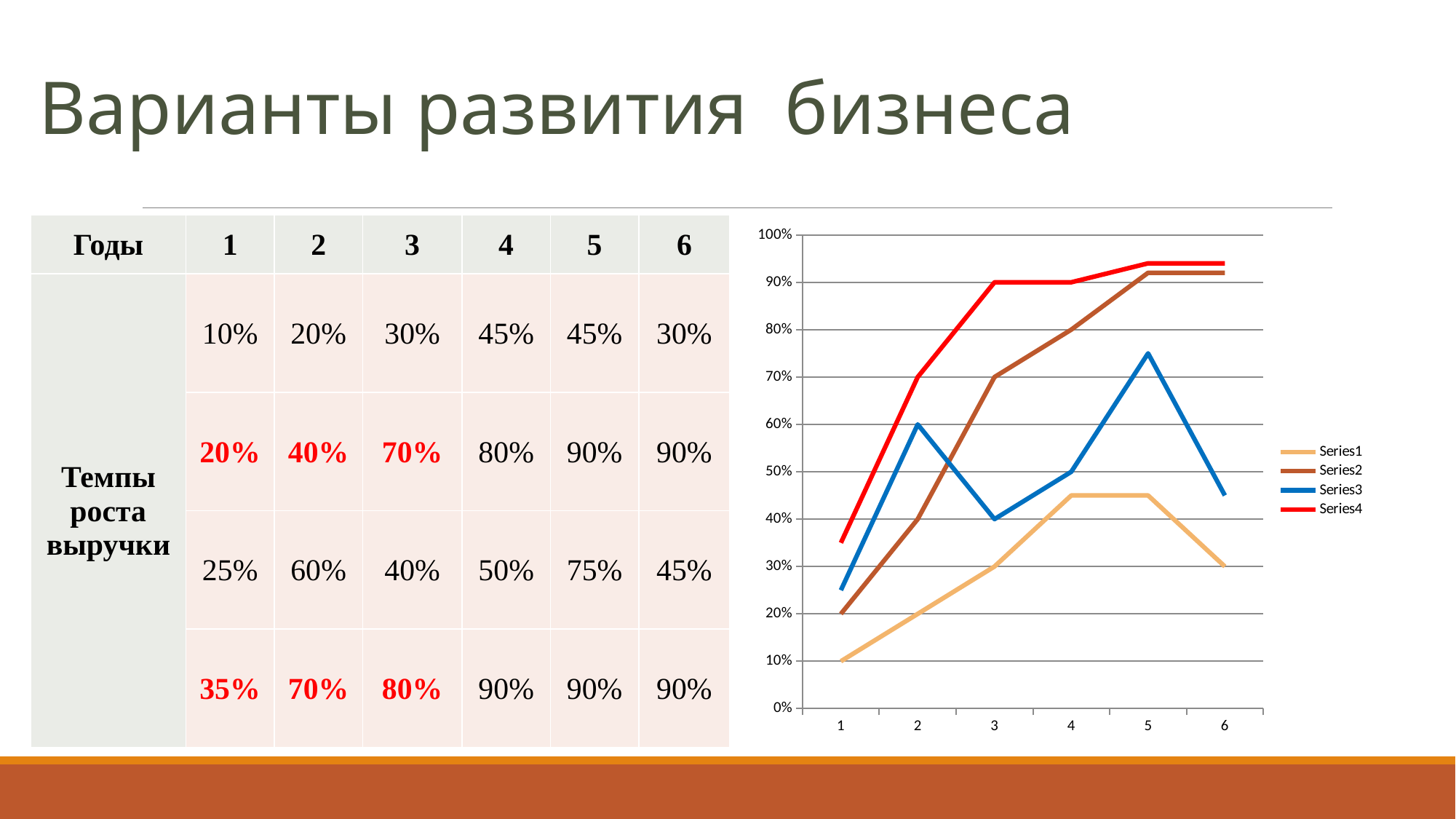
What is the value of Series2 at point 3? 70% What is the value of Series1 at point 1? 10% What is the value of Series4 at point 3? 90% Which series has the highest value at point 6? Series4 At point 2, which is larger: Series3 or Series2? Series3 Which series has the lowest value at point 1? Series1 How many series does the chart legend list? 4 What kind of chart is shown on the slide? line chart How many points are on the x axis of the chart? 6 Is the value for Series3 at point 5 greater or less than 70%? greater Does Series2 rise or fall from point 1 to point 4? rise What is the value of Series3 at point 2? 60%